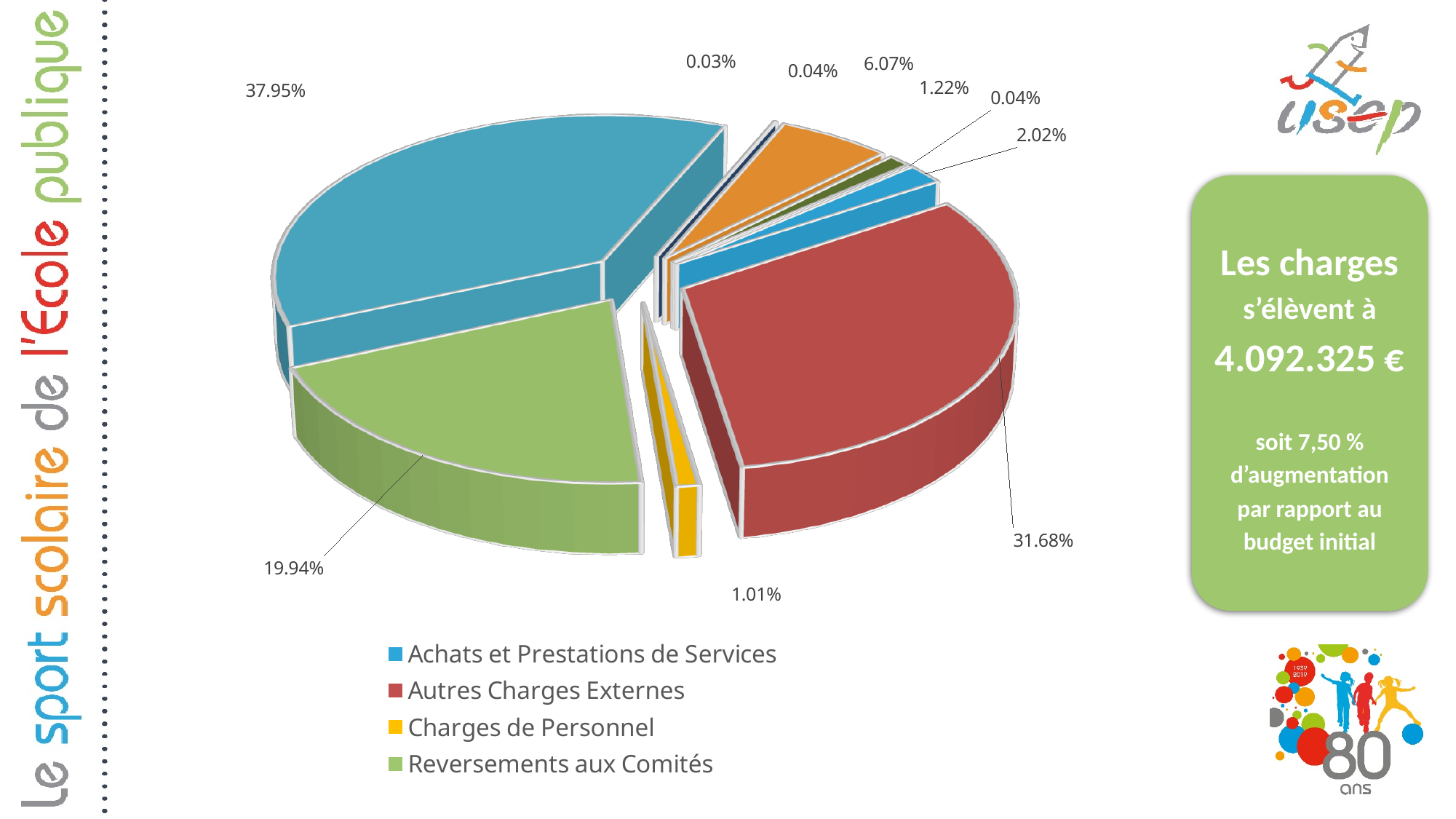
What kind of chart is shown on the slide? pie chart What is the difference in percentage points between the largest slice (37.95%) and the second largest slice (31.68%)? 6.27 What colour represents Charges de Personnel in the legend? yellow What share of the pie is Autres Charges Externes? 31.68% What is the largest percentage labelled on the pie chart? 37.95% How many percentage labels are shown around the pie chart? 10 What share of the pie is Reversements aux Comités? 19.94% What share of the pie is Charges de Personnel? 1.01% How many entries does the legend list? 4 What is the smallest percentage labelled on the pie chart? 0.03% What is the difference in percentage points between Autres Charges Externes (31.68%) and Reversements aux Comités (19.94%)? 11.74 Which is larger: Autres Charges Externes or Reversements aux Comités? Autres Charges Externes